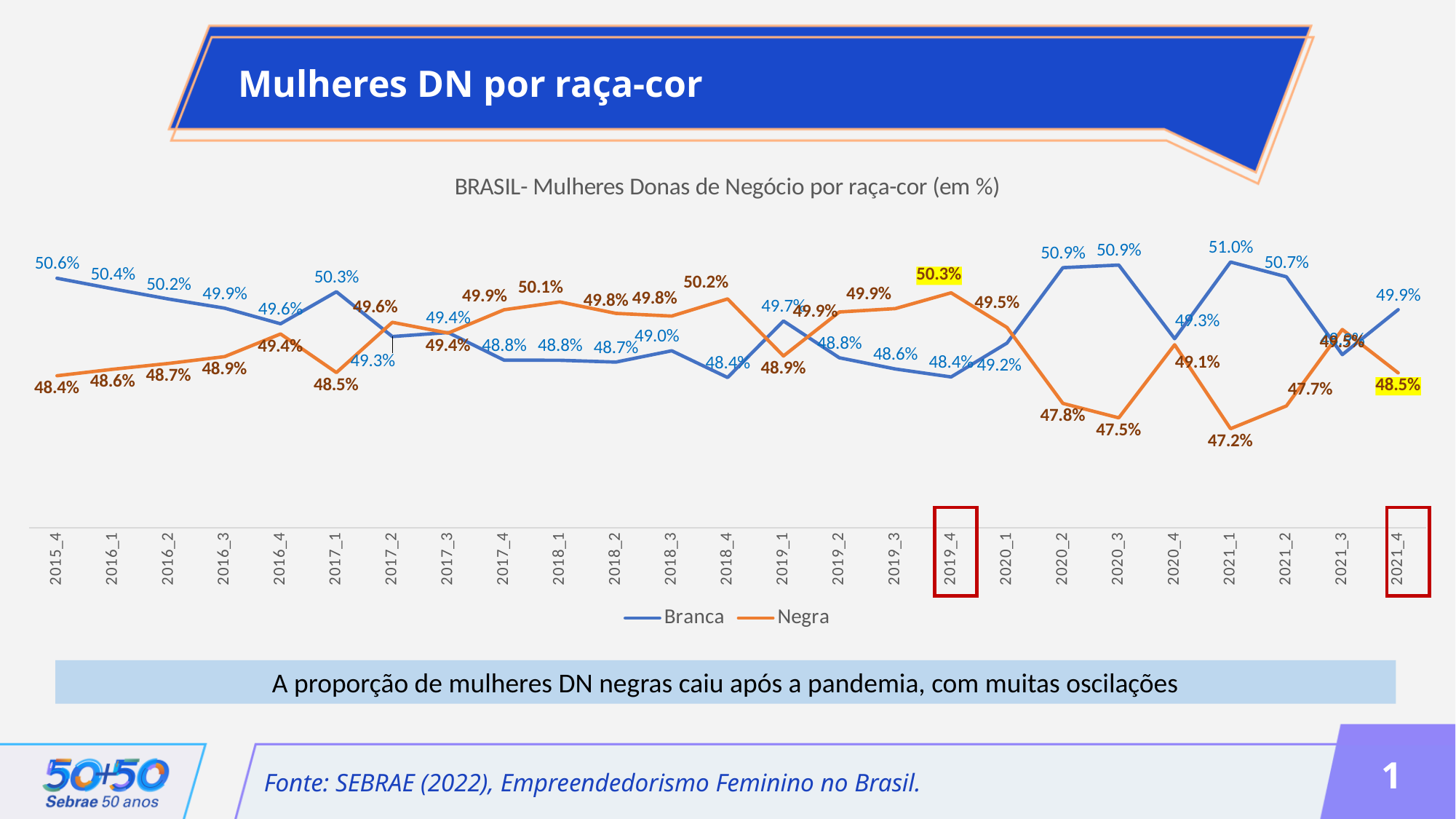
How many time periods are plotted along the x axis? 25 What is the value for Negra in 2019_4? 50.3% What is the value for Branca in 2015_4? 50.6% What is the difference between the Branca and Negra values in 2021_4? 1.4 percentage points What are the two series named in the legend? Branca and Negra In which period does the Branca series reach its highest value? 2021_1 In which period does the Negra series reach its lowest value? 2021_1 In 2020_2, which series has the higher value, Branca or Negra? Branca How many series does the legend list? 2 What kind of chart is shown on the slide? Line chart What is the value for Negra in 2021_4? 48.5% What is the value for Branca in 2020_3? 50.9%